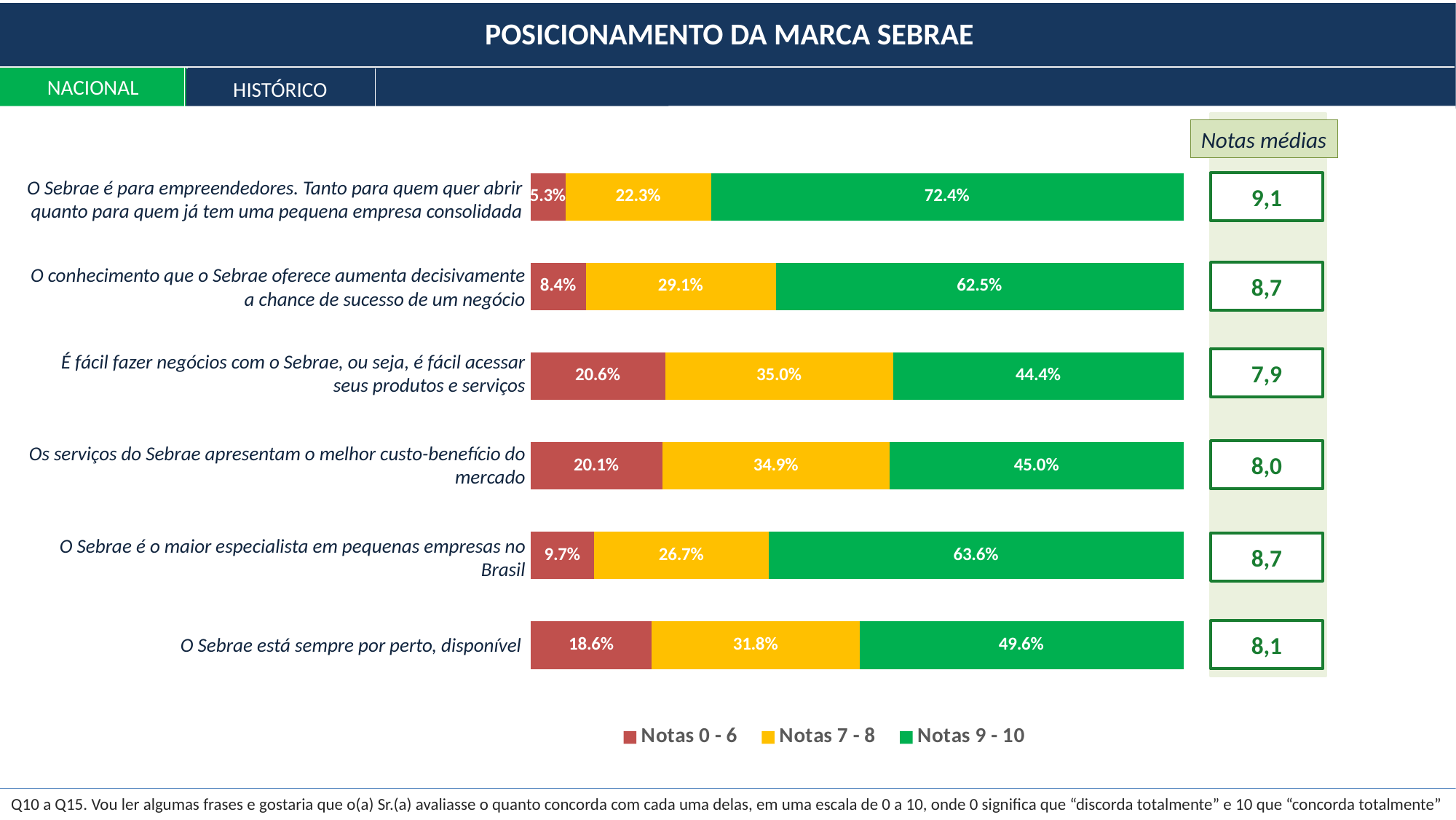
What kind of chart is shown on the slide? Stacked bar chart How many series does the legend list? 3 Which statement has a larger Notas 0 - 6 share: "O conhecimento que o Sebrae oferece aumenta decisivamente a chance de sucesso de um negócio" or "O Sebrae é o maior especialista em pequenas empresas no Brasil"? O Sebrae é o maior especialista em pequenas empresas no Brasil What is the difference in the Notas 9 - 10 share between "O Sebrae é o maior especialista em pequenas empresas no Brasil" and "O Sebrae está sempre por perto, disponível"? 14.0 percentage points What is the Notas 7 - 8 value for the statement "O conhecimento que o Sebrae oferece aumenta decisivamente a chance de sucesso de um negócio"? 29.1% Which statement has the lowest share of Notas 0 - 6? O Sebrae é para empreendedores. Tanto para quem quer abrir quanto para quem já tem uma pequena empresa consolidada How many statements are shown in the chart? 6 What is the total of the stacked bar for "O Sebrae está sempre por perto, disponível"? 100.0% Which statement has the highest share of Notas 9 - 10? O Sebrae é para empreendedores. Tanto para quem quer abrir quanto para quem já tem uma pequena empresa consolidada What percentage of respondents gave Notas 9 - 10 to the statement "O Sebrae é para empreendedores. Tanto para quem quer abrir quanto para quem já tem uma pequena empresa consolidada"? 72.4% What is the Nota média shown for the statement "É fácil fazer negócios com o Sebrae, ou seja, é fácil acessar seus produtos e serviços"? 7,9 What is the Notas 0 - 6 value for the statement "É fácil fazer negócios com o Sebrae, ou seja, é fácil acessar seus produtos e serviços"? 20.6%